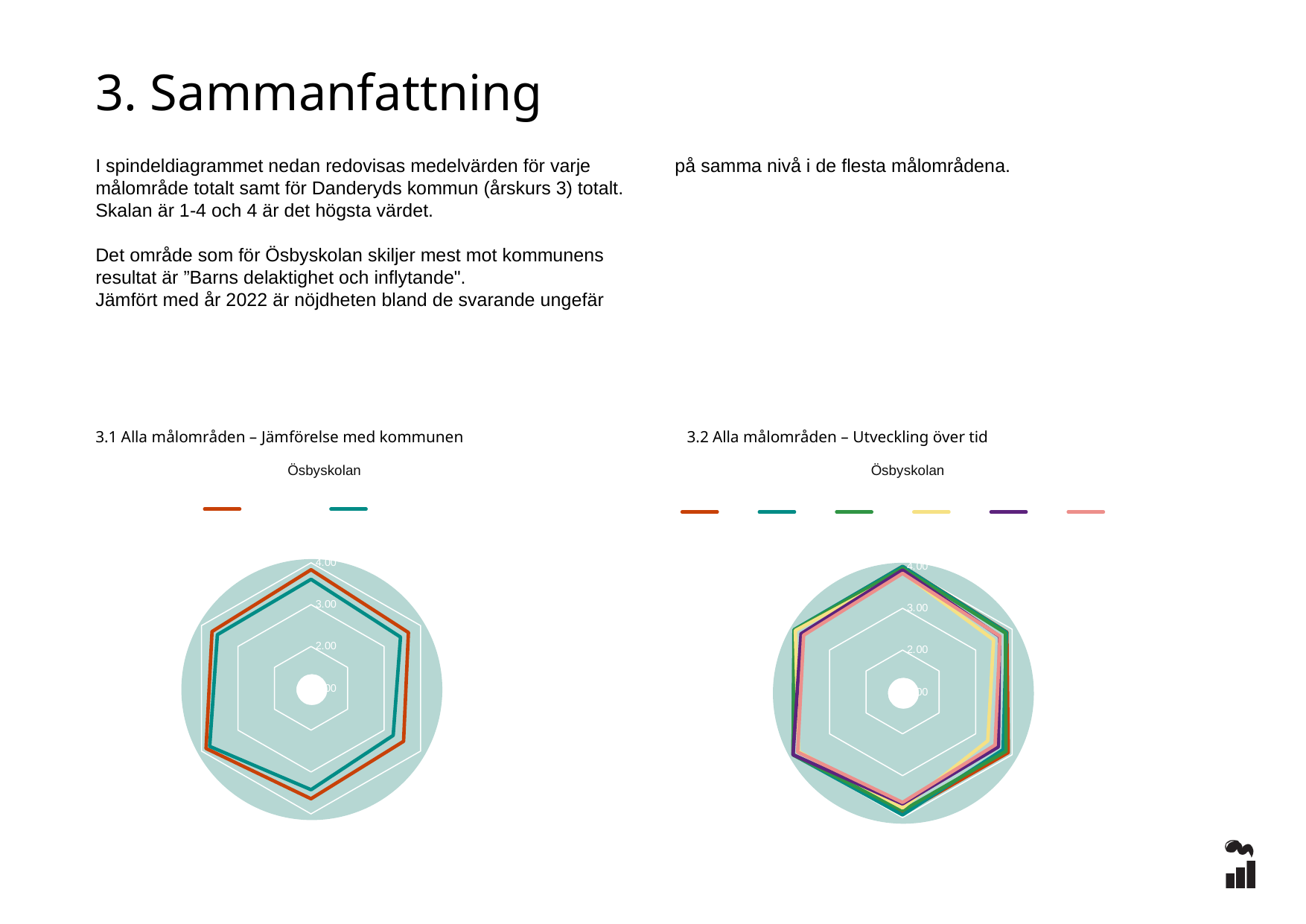
In the right chart (3.2 Utveckling över tid), is the value at the top axis greater or less than 3.00? greater How many series does the legend of the left chart (3.1 Jämförelse med kommunen) list? 2 What is the highest value labelled on the scale of the right radar chart (3.2 Utveckling över tid)? 4.00 How many axes (categories) does the left radar chart (3.1 Jämförelse med kommunen) have? 6 How many axes (categories) does the right radar chart (3.2 Utveckling över tid) have? 6 What is the title shown above the left radar chart (3.1 Jämförelse med kommunen)? Ösbyskolan How many series does the legend of the right chart (3.2 Utveckling över tid) list? 6 In the left chart (3.1 Jämförelse med kommunen), is the value at the top axis greater or less than 3.00? greater What kind of chart is the left chart (3.1 Alla målområden – Jämförelse med kommunen)? Radar chart What kind of chart is the right chart (3.2 Alla målområden – Utveckling över tid)? Radar chart